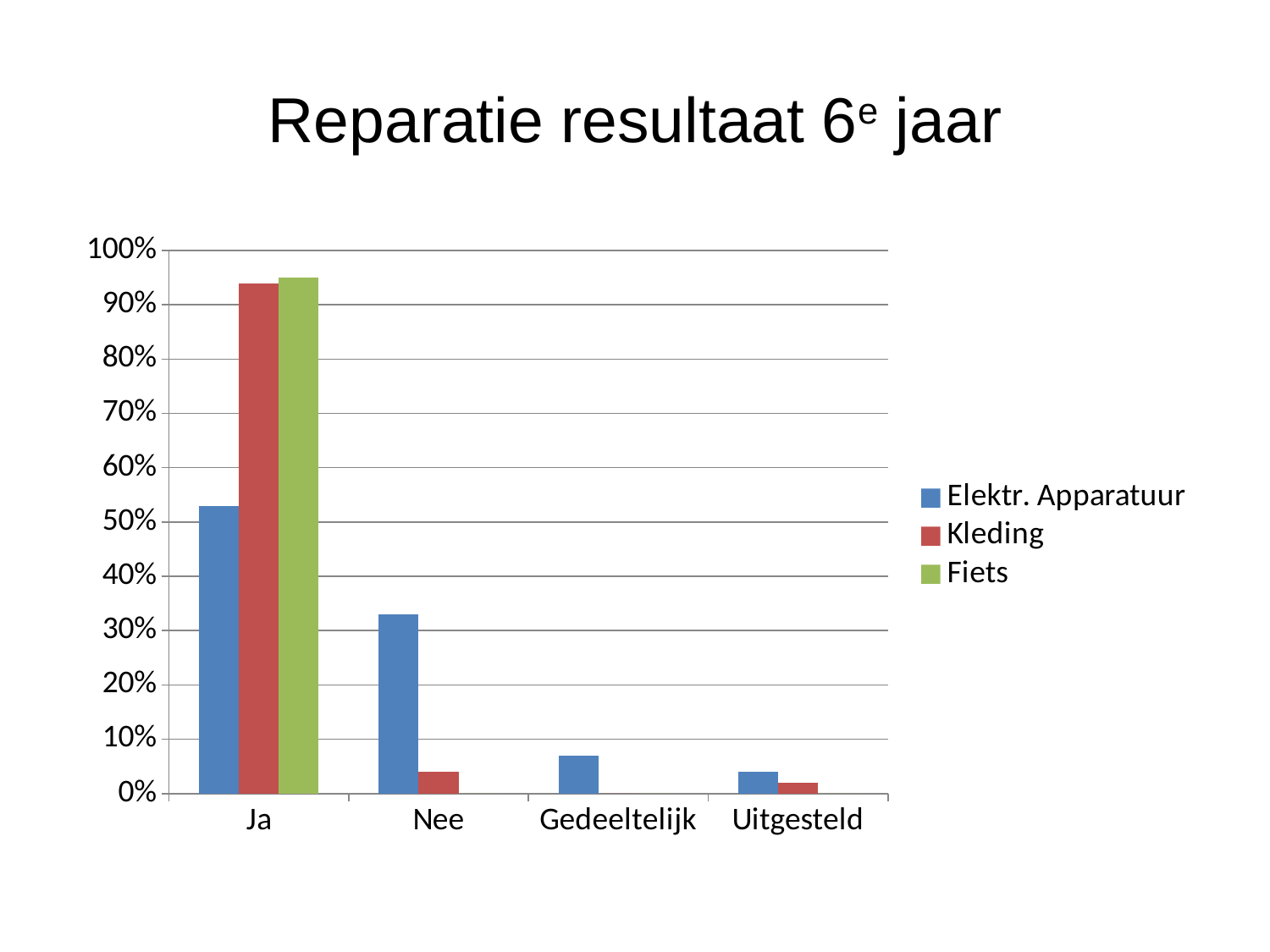
What kind of chart is shown on the slide? bar chart Is the Elektr. Apparatuur value for Ja greater or less than 60%? less How many series does the legend list? 3 Is the Kleding value for Nee greater or less than 10%? less Which series is shown in green in the legend? Fiets Is the Kleding value for Ja greater or less than 90%? greater For the Ja category, which is larger: Elektr. Apparatuur or Kleding? Kleding What is the title of the chart on the slide? Reparatie resultaat 6e jaar For which category is the Elektr. Apparatuur value highest? Ja How many categories are shown on the x axis? 4 For Elektr. Apparatuur, which is larger: Nee or Gedeeltelijk? Nee